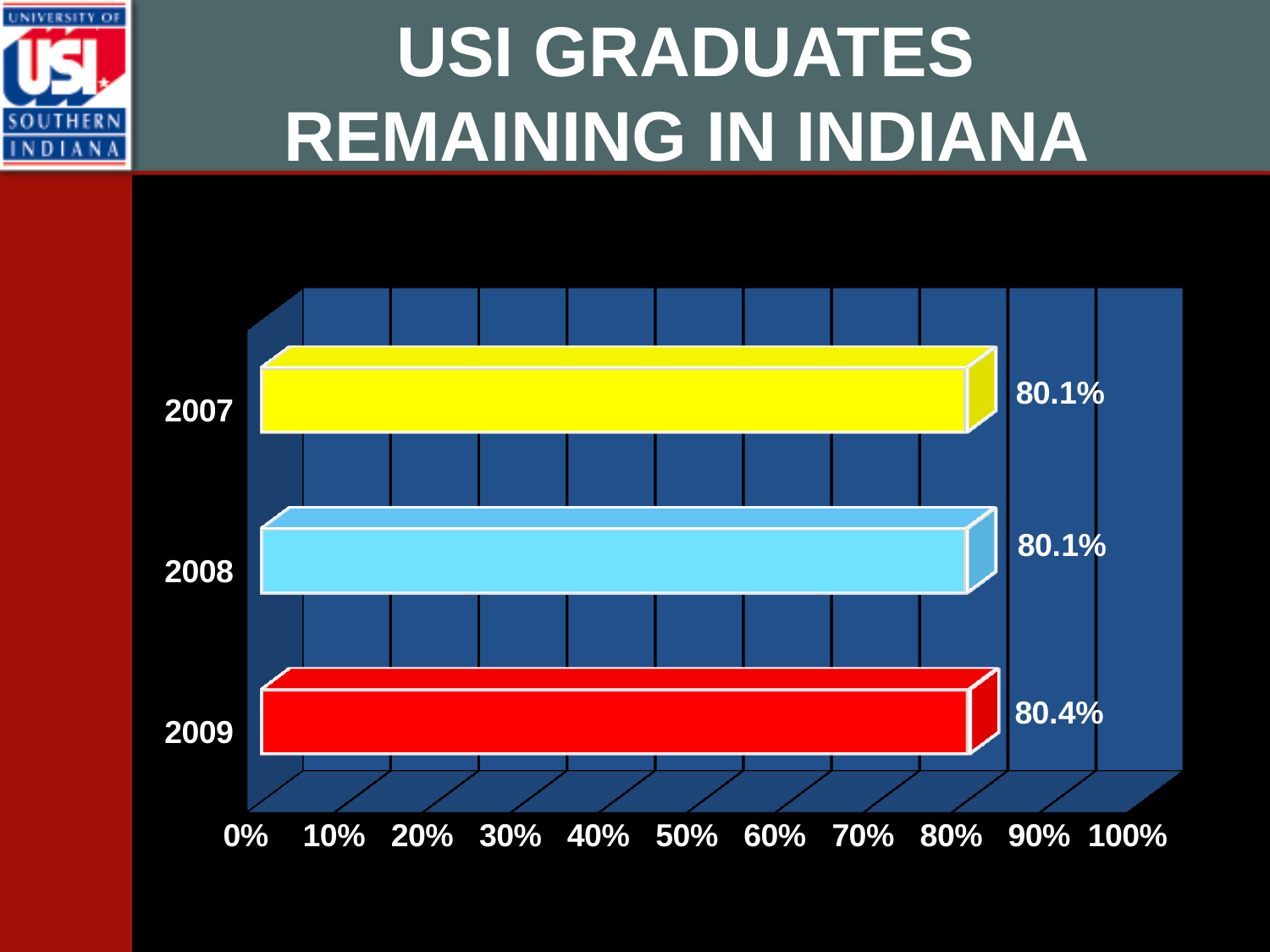
What colour is the bar for 2009? red How many years are shown in the chart? 3 Do the values rise or fall from 2007 to 2009? rise Is the value for 2009 greater or less than 90%? less What percentage of USI graduates remained in Indiana in 2009? 80.4% Which is larger, the value for 2009 or the value for 2008? 2009 What is the value shown for 2008? 80.1% What is the difference between the 2009 value and the 2007 value? 0.3% What kind of chart is shown on the slide? bar chart Is the value for 2007 greater or less than 70%? greater What is the value shown for 2007? 80.1% Which year has the highest percentage of graduates remaining in Indiana? 2009